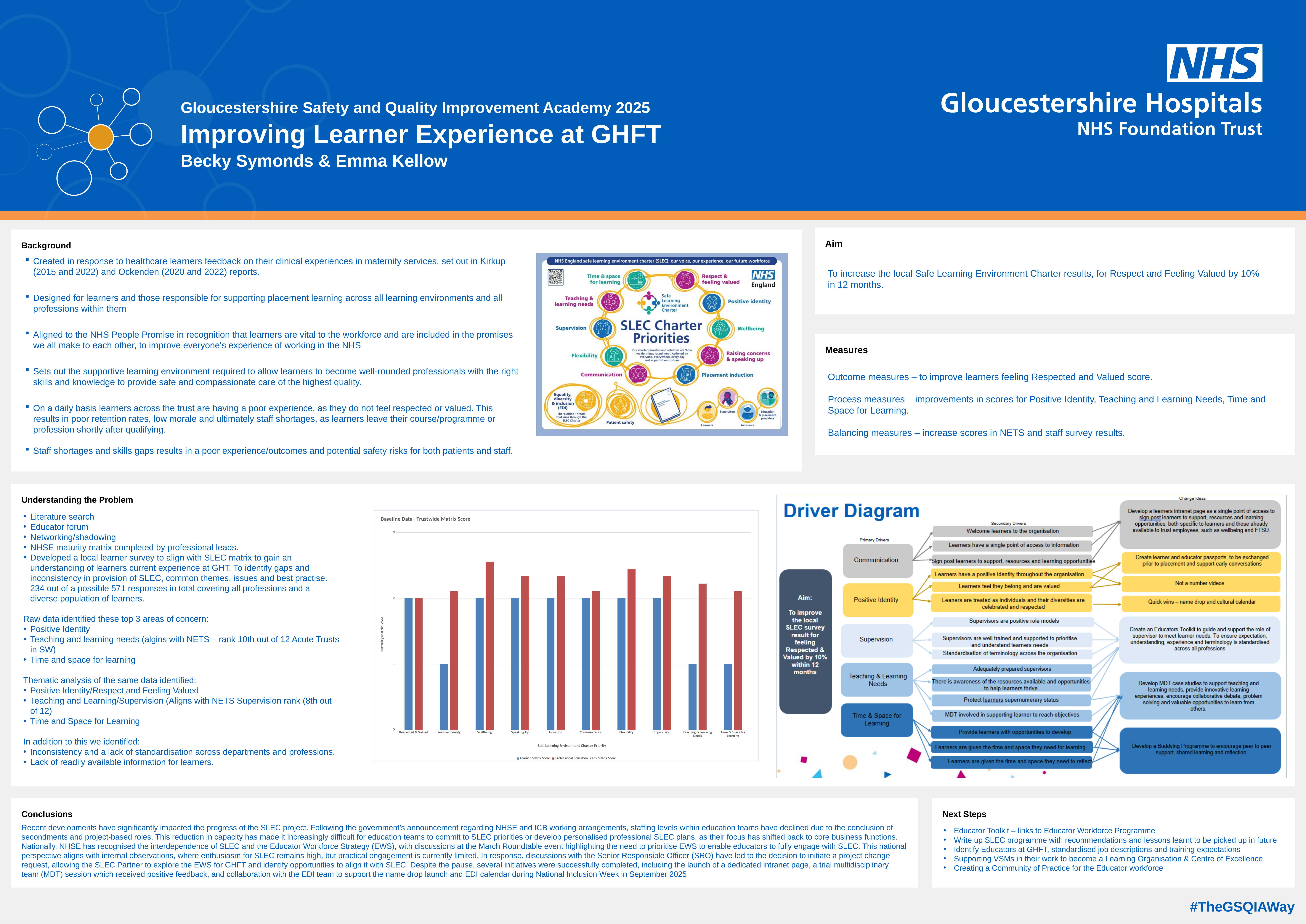
Is the Professional Education Leads Matrix Score for Wellbeing greater or less than 2? greater Is the Professional Education Leads Matrix Score for Flexibility greater or less than 3? less How many series does the chart's legend list? 2 What is the Professional Education Leads Matrix Score for Respected & Valued? 2 For Teaching & Learning Needs, which is larger: the Learner Matrix Score or the Professional Education Leads Matrix Score? Professional Education Leads Matrix Score What is the label on the chart's y axis? Maturity Matrix Score What is the Learner Matrix Score for Respected & Valued? 2 What is the Learner Matrix Score for Positive Identity? 1 How many Safe Learning Environment Charter priorities are shown on the x axis of the chart? 10 What type of chart is shown under 'Understanding the Problem'? bar chart What is the title of the chart? Baseline Data - Trustwide Matrix Score What is the Learner Matrix Score for Time & Space for Learning? 1